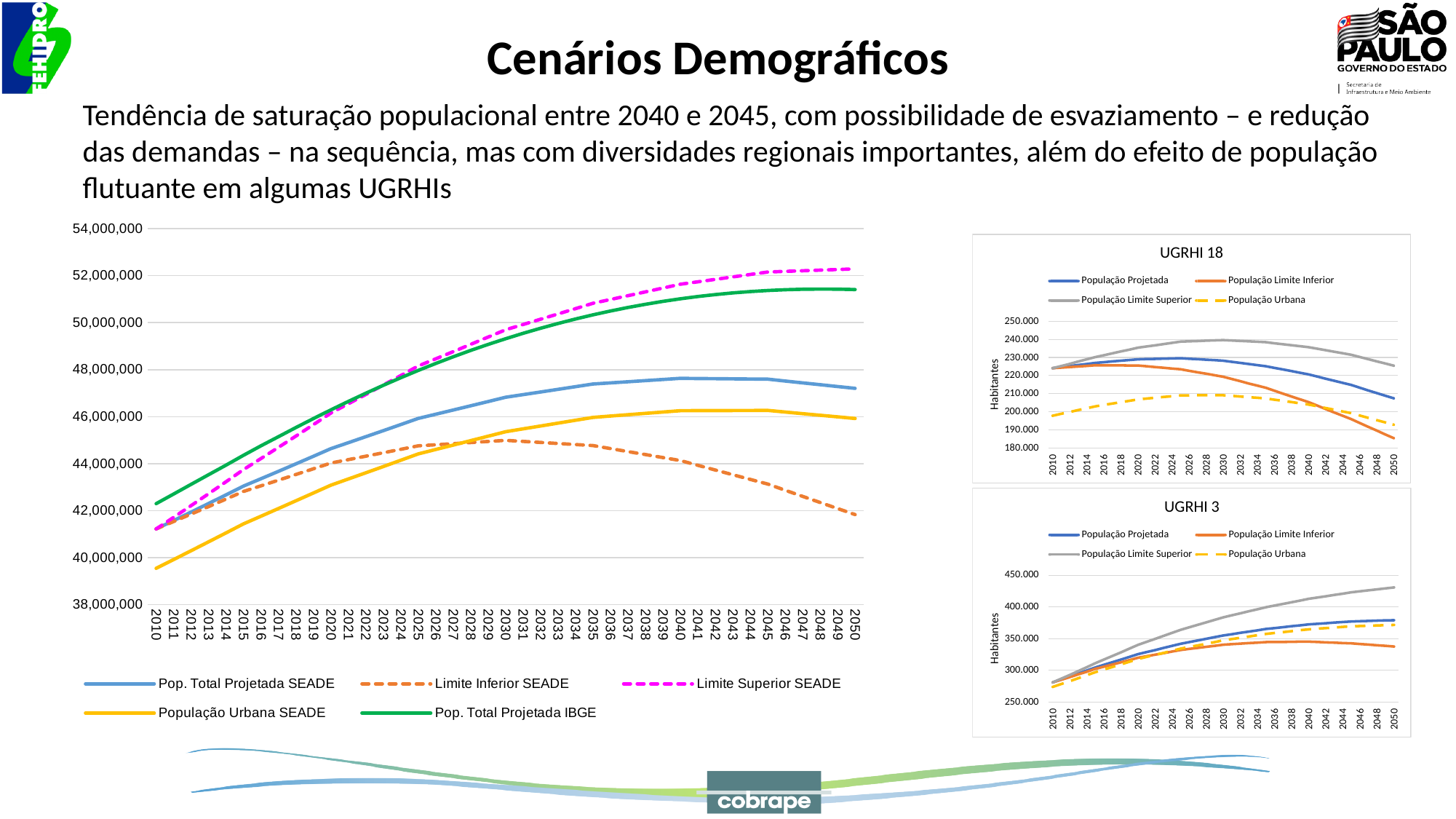
In the UGRHI 3 chart, does the População Limite Superior series rise or fall from 2010 to 2050? rise In the UGRHI 18 chart, is the value for População Limite Inferior in 2050 greater or less than 190.000? less In the large chart on the left, is the value for Limite Superior SEADE in 2050 greater or less than 52,000,000? greater In the large chart on the left, is the value for Pop. Total Projetada IBGE in 2050 greater or less than 52,000,000? less In the large chart on the left, which series has the higher value in 2050: Limite Superior SEADE or Pop. Total Projetada SEADE? Limite Superior SEADE How many series does the legend of the large chart on the left list? 5 In the large chart on the left, does the Limite Inferior SEADE series rise or fall between 2030 and 2050? fall What kind of chart is the large chart on the left of the slide? line chart How many series does the legend of the UGRHI 18 chart list? 4